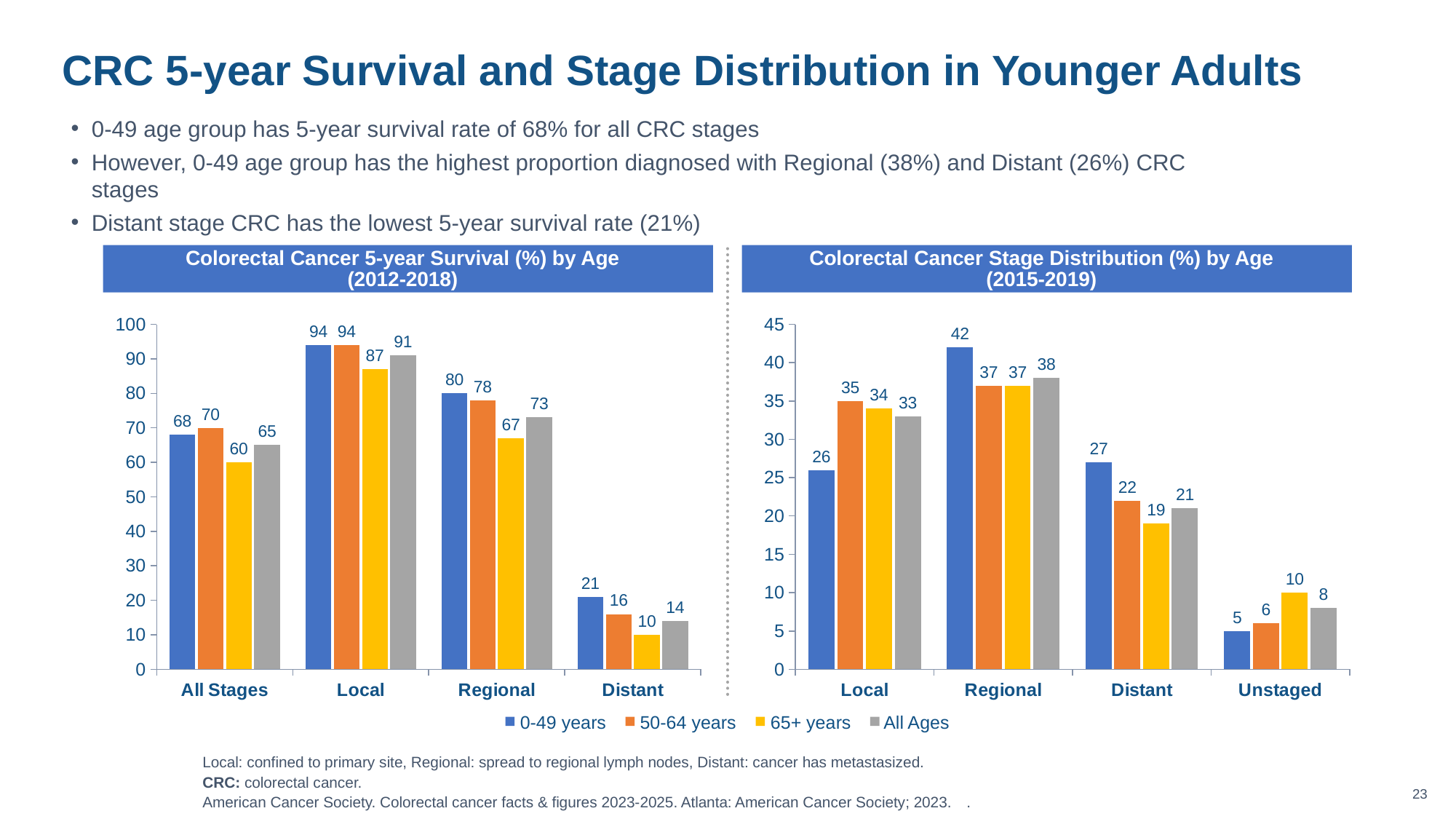
In the 'Colorectal Cancer Stage Distribution (%) by Age (2015-2019)' chart, which is larger in the Local category: 0-49 years or 50-64 years? 50-64 years In the 'Colorectal Cancer 5-year Survival (%) by Age (2012-2018)' chart, what is the value for 65+ years in the Distant category? 10 In the 'Colorectal Cancer Stage Distribution (%) by Age (2015-2019)' chart, what is the value for All Ages in the Unstaged category? 8 In the 'Colorectal Cancer 5-year Survival (%) by Age (2012-2018)' chart, which category has the lowest value for All Ages? Distant In the 'Colorectal Cancer 5-year Survival (%) by Age (2012-2018)' chart, what is the difference between the 0-49 years and 65+ years values in the Regional category? 13 How many categories are shown on the x axis of the 'Colorectal Cancer Stage Distribution (%) by Age (2015-2019)' chart? 4 What kind of chart is the 'Colorectal Cancer 5-year Survival (%) by Age (2012-2018)' chart? Bar chart In the 'Colorectal Cancer Stage Distribution (%) by Age (2015-2019)' chart, what is the difference between the 0-49 years and All Ages values in the Distant category? 6 In the 'Colorectal Cancer 5-year Survival (%) by Age (2012-2018)' chart, what is the value for 0-49 years in the All Stages category? 68 In the 'Colorectal Cancer Stage Distribution (%) by Age (2015-2019)' chart, what is the value for 0-49 years in the Regional category? 42 In the 'Colorectal Cancer Stage Distribution (%) by Age (2015-2019)' chart, which category has the highest value for 0-49 years? Regional How many series does the legend list for the charts on the slide? 4